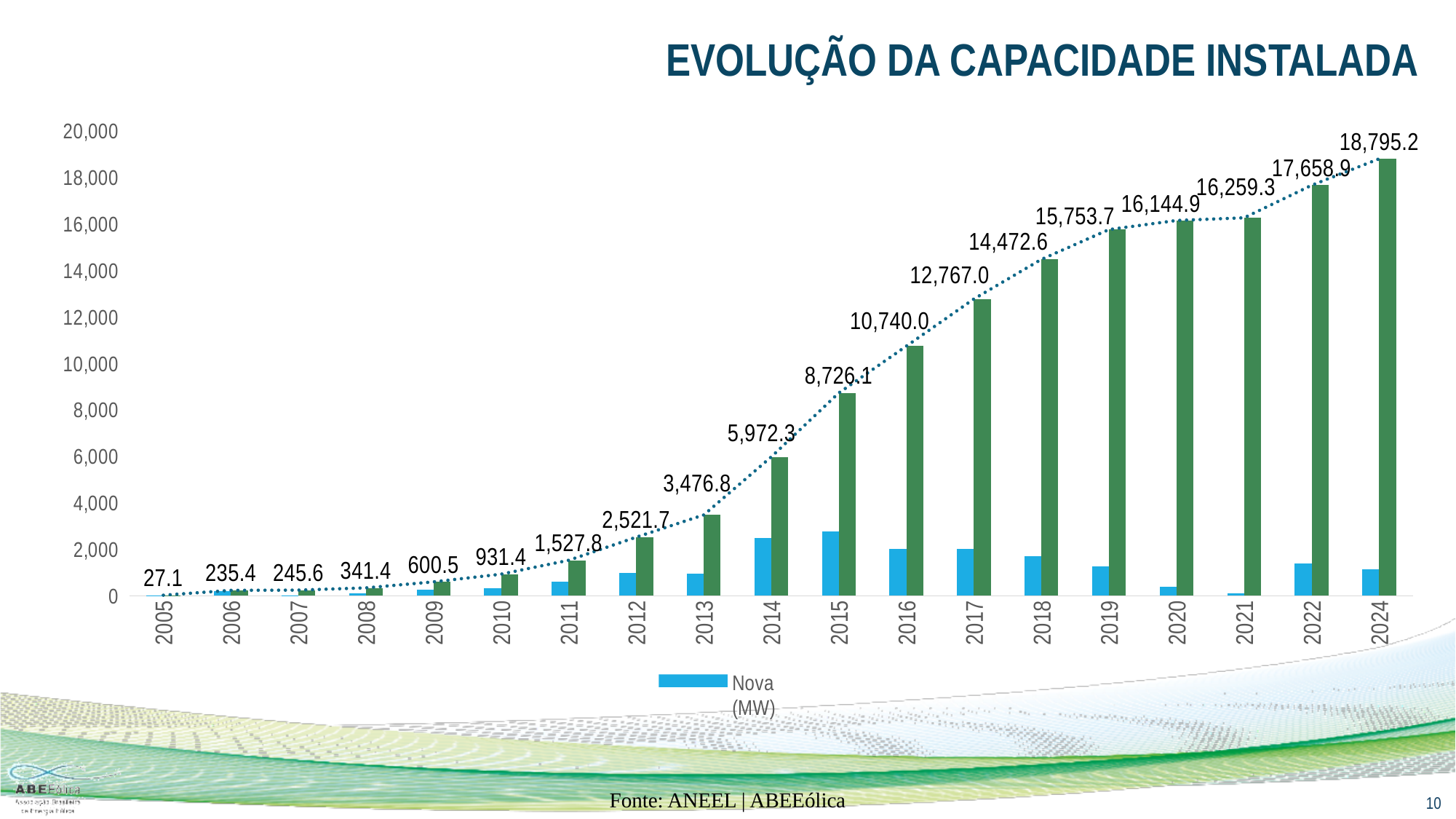
Is the value of the blue 'Nova (MW)' bar for 2015 greater or less than 2,000? greater What is the difference between the labelled values for 2024 and 2022? 1,136.3 Is the value of the blue 'Nova (MW)' bar for 2020 greater or less than 2,000? less How many years are shown on the x axis? 19 What is the labelled value for 2015? 8,726.1 Do the labelled values rise or fall from 2005 to 2024? rise Which year has the highest labelled value? 2024 What is the difference between the labelled values for 2013 and 2012? 955.1 What is the labelled value for 2010? 931.4 Which year has the lowest labelled value? 2005 What is the labelled value for 2024? 18,795.2 Which is larger, the labelled value for 2017 or for 2016? 2017